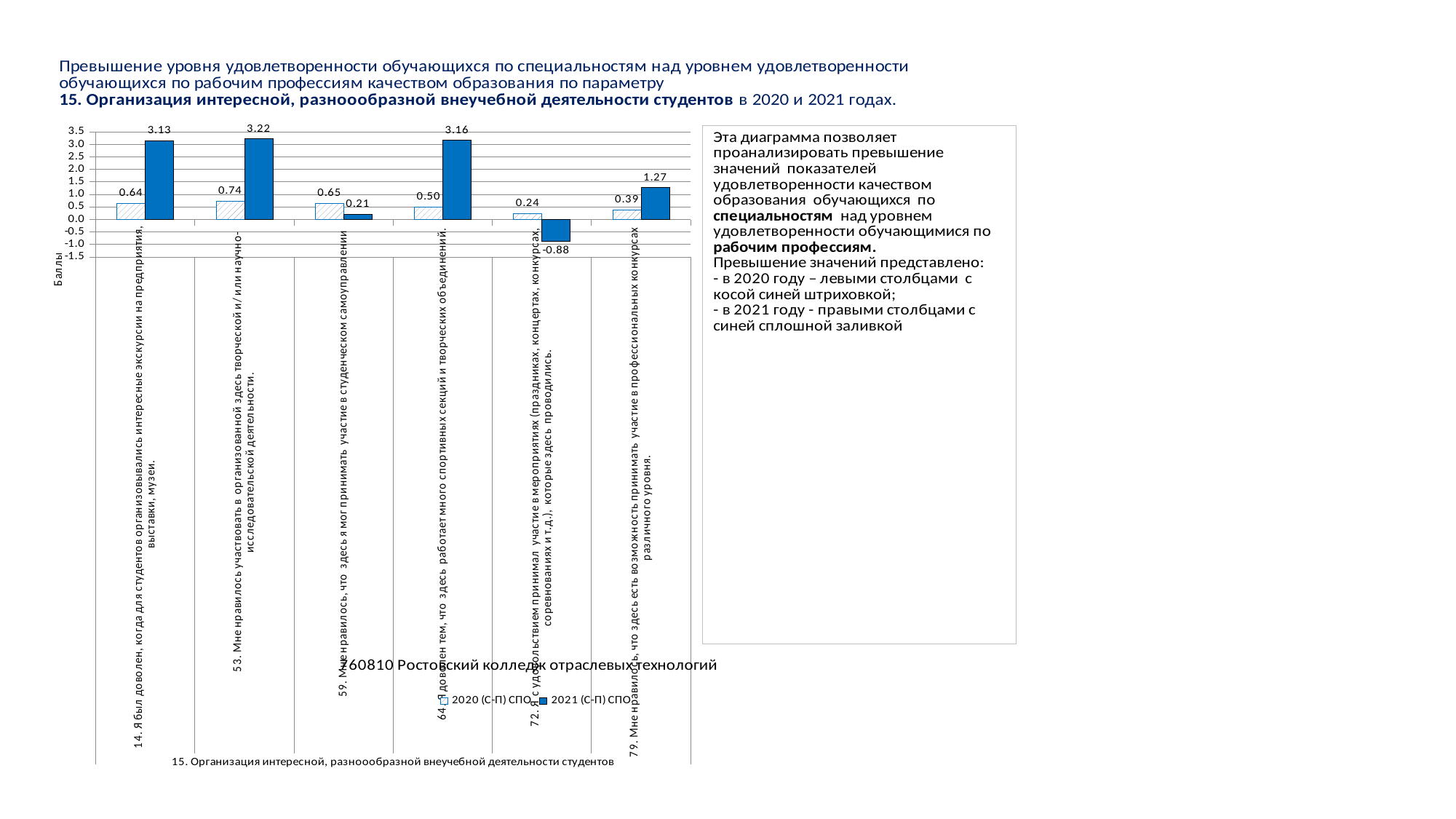
Какого типа эта диаграмма? Столбчатая (bar chart) Как называется ось значений (вертикальная ось) диаграммы? Баллы Что больше по пункту 59 (студенческое самоуправление): значение 2020 (С-П) СПО или 2021 (С-П) СПО? 2020 (С-П) СПО По какому пункту значение 2021 (С-П) СПО самое высокое? 53. Мне нравилось участвовать в организованной здесь творческой и/или научно-исследовательской деятельности. Сколько пунктов (категорий) показано на диаграмме? 6 По какому пункту значение 2021 (С-П) СПО самое низкое? 72. Я с удовольствием принимал участие в мероприятиях (праздниках, концертах, конкурсах, соревнованиях и т.д.), которые здесь проводились. На сколько значение 2021 (С-П) СПО по пункту 64 (спортивные секции и творческие объединения) больше значения 2020 (С-П) СПО по этому же пункту? 2.66 По какому пункту значение 2020 (С-П) СПО самое низкое? 72. Я с удовольствием принимал участие в мероприятиях (праздниках, концертах, конкурсах, соревнованиях и т.д.), которые здесь проводились. Сколько рядов данных указано в легенде диаграммы? 2 Какое значение показано для 2021 (С-П) СПО по пункту 72 (участие в мероприятиях: праздниках, концертах, конкурсах)? -0.88 Какое значение показано для 2021 (С-П) СПО по пункту 53 (участие в творческой и/или научно-исследовательской деятельности)? 3.22 Какое значение показано для 2020 (С-П) СПО по пункту 14 (экскурсии на предприятия, выставки, музеи)? 0.64